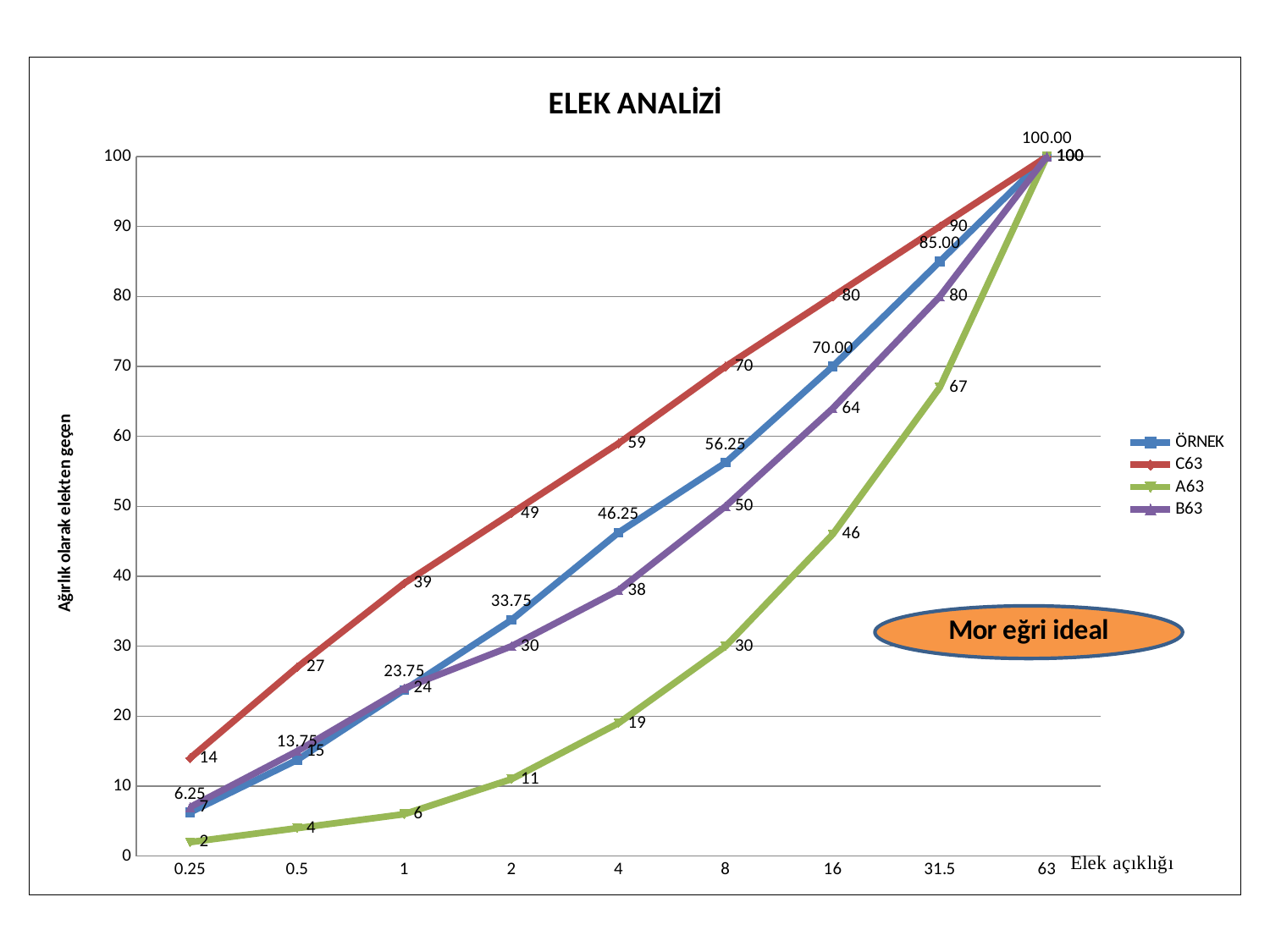
Do the values of the A63 series rise or fall as the sieve opening increases along the x axis? rise What is the value of the B63 series at sieve opening 8? 50 What is the value of the A63 series at sieve opening 31.5? 67 What is the value of the ÖRNEK series at sieve opening 4? 46.25 How many sieve opening (Elek açıklığı) categories are shown on the x axis? 9 How many series does the legend list? 4 Which series has the highest value at sieve opening 16? C63 What is the value of the C63 series at sieve opening 1? 39 What type of chart is shown on the slide? line chart What is the difference between the C63 and A63 values at sieve opening 2? 38 Which series has the lowest value at sieve opening 0.25? A63 What is the title of the chart? ELEK ANALİZİ